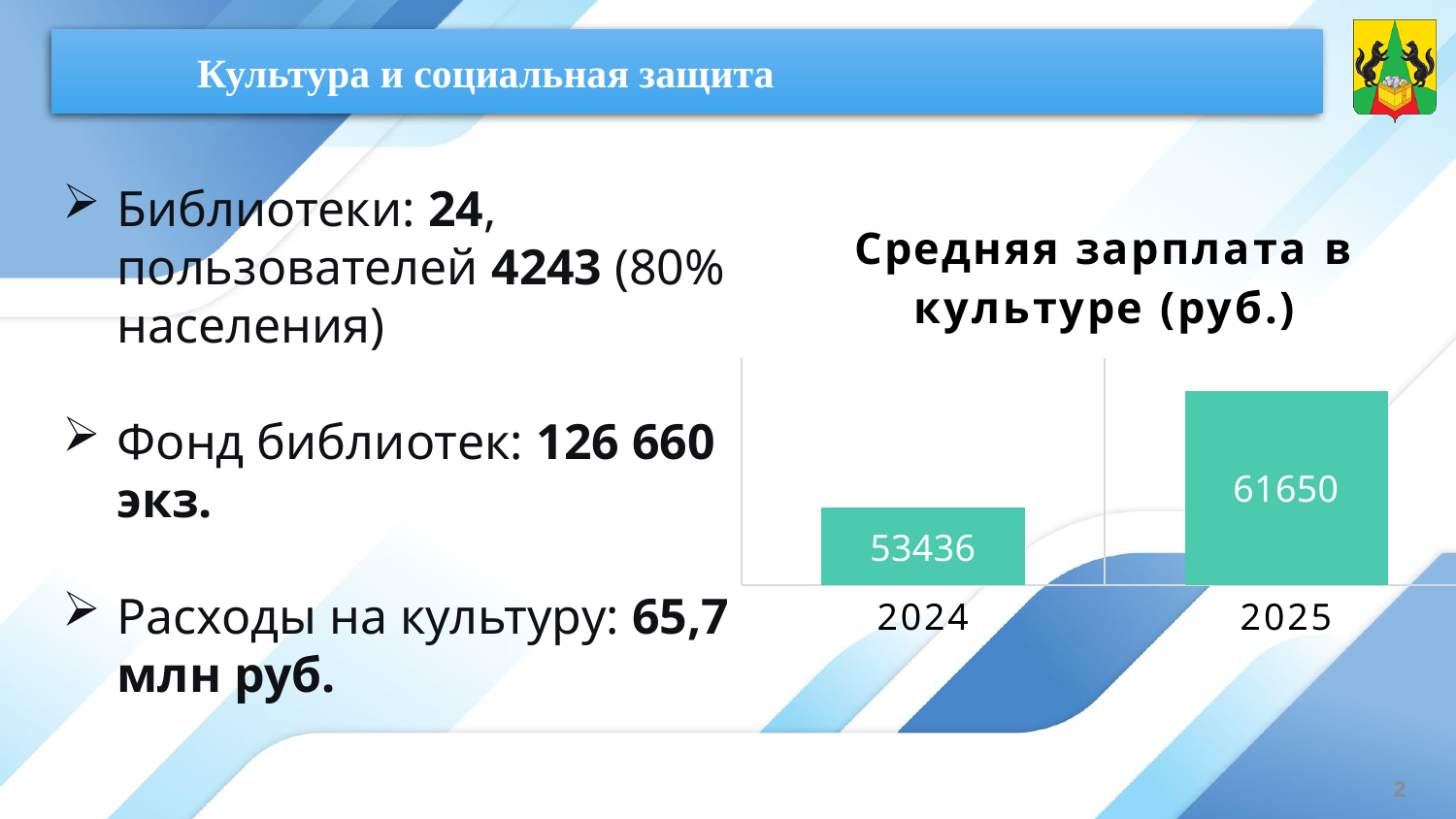
What colour are the bars in the chart? green How many years are shown in the chart? 2 What is the title of the chart? Средняя зарплата в культуре (руб.) What type of chart is used to show the average salary in culture? bar chart Does the average salary in culture rise or fall from 2024 to 2025? rise By how much did the average salary in culture increase from 2024 to 2025? 8214 What is the average salary in culture for 2024? 53436 Is the average salary in culture larger in 2024 or in 2025? 2025 What is the average salary in culture for 2025? 61650 Which year has the higher average salary in culture? 2025 Which year has the lower average salary in culture? 2024